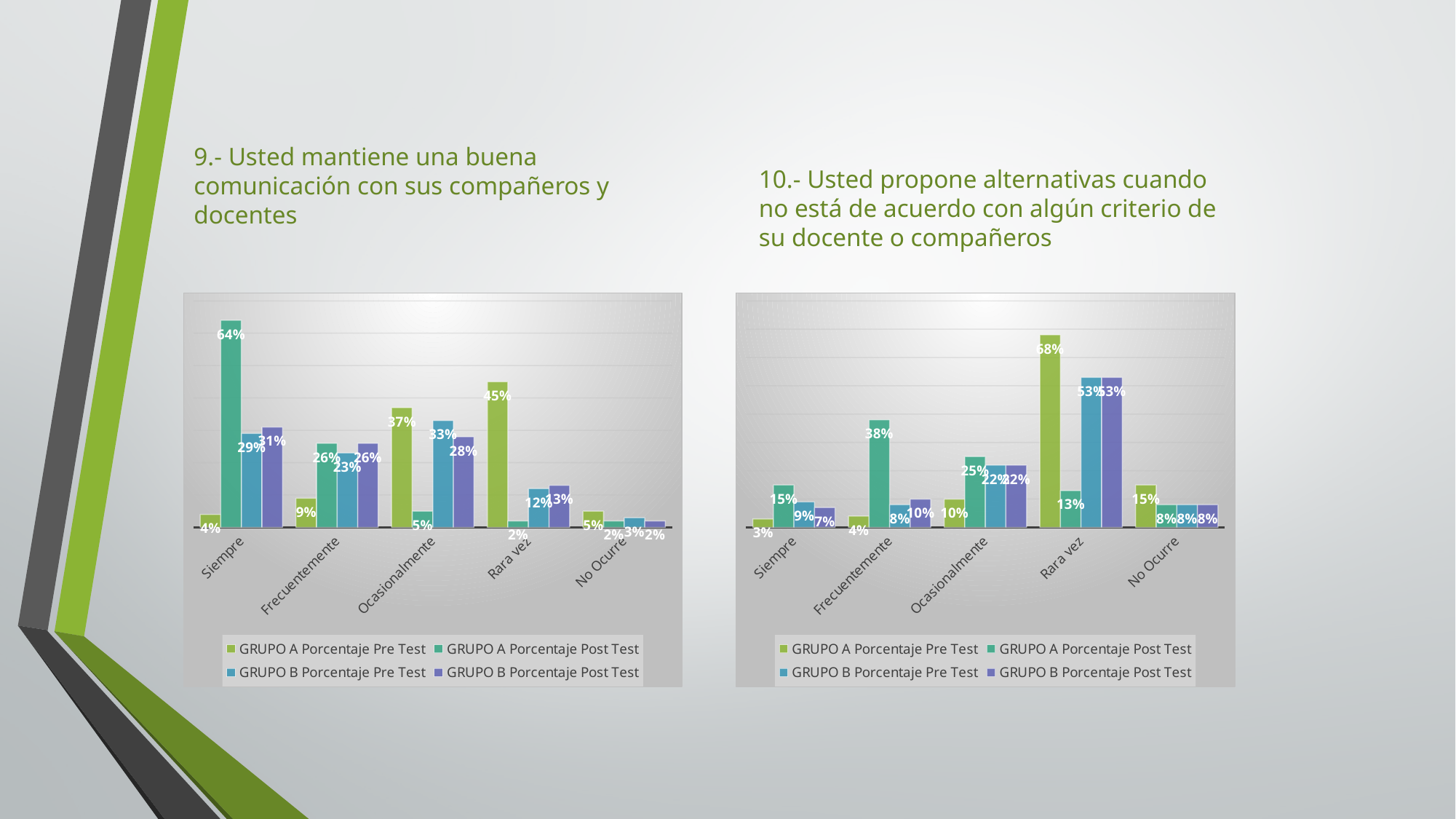
In the right chart (question 10), what is the GRUPO A Porcentaje Pre Test value for Rara vez? 68% In the right chart (question 10), what is the difference between the GRUPO A Pre Test and GRUPO A Post Test values for Rara vez? 55% In the right chart (question 10), which category has the lowest GRUPO A Porcentaje Pre Test value? Siempre In the left chart (question 9), which is larger for Ocasionalmente: GRUPO A Pre Test or GRUPO B Pre Test? GRUPO A Pre Test In the left chart (question 9), what is the GRUPO A Porcentaje Pre Test value for Rara vez? 45% In the left chart (question 9), which category has the highest GRUPO B Porcentaje Pre Test value? Ocasionalmente In the right chart (question 10), what is the GRUPO A Porcentaje Post Test value for Frecuentemente? 38% How many categories are shown on the x axis of the right chart (question 10)? 5 In the left chart (question 9), what is the GRUPO A Porcentaje Post Test value for Siempre? 64% How many series does the legend of the left chart (question 9) list? 4 In the left chart (question 9), what is the difference between the GRUPO A Post Test and GRUPO A Pre Test values for Siempre? 60% What type of chart is the right chart (question 10)? Bar chart